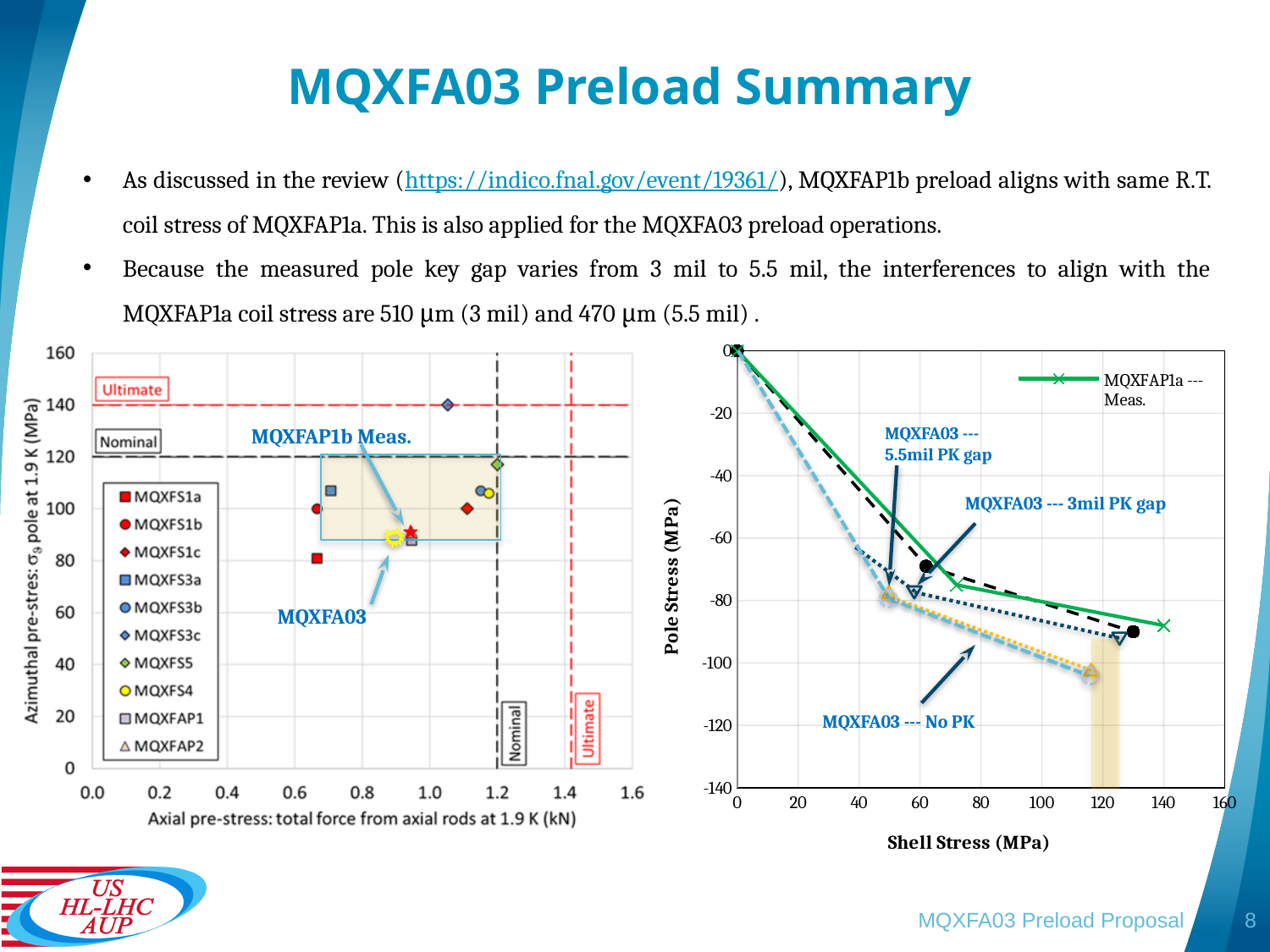
In the left chart, is the azimuthal pre-stress of the MQXFS3c point greater or less than 120? greater In the left chart, at what axial pre-stress value is the 'Nominal' vertical reference line drawn? 1.2 How many series does the legend of the left chart list? 10 What is the x-axis title of the right chart? Shell Stress (MPa) In the left chart, is the axial pre-stress of the MQXFS5 point greater or less than 1.0? greater In the right chart, does the pole stress of the MQXFAP1a --- Meas. series rise or fall as shell stress increases? fall What kind of chart is the right chart (Pole Stress vs Shell Stress)? line chart What kind of chart is the left chart (Azimuthal pre-stress vs Axial pre-stress)? scatter plot In the right chart, is the pole stress of the MQXFAP1a --- Meas. series at its highest shell stress point greater or less than -80? less How many series does the legend of the right chart list? 1 In the left chart, at what azimuthal pre-stress value is the 'Ultimate' horizontal reference line drawn? 140